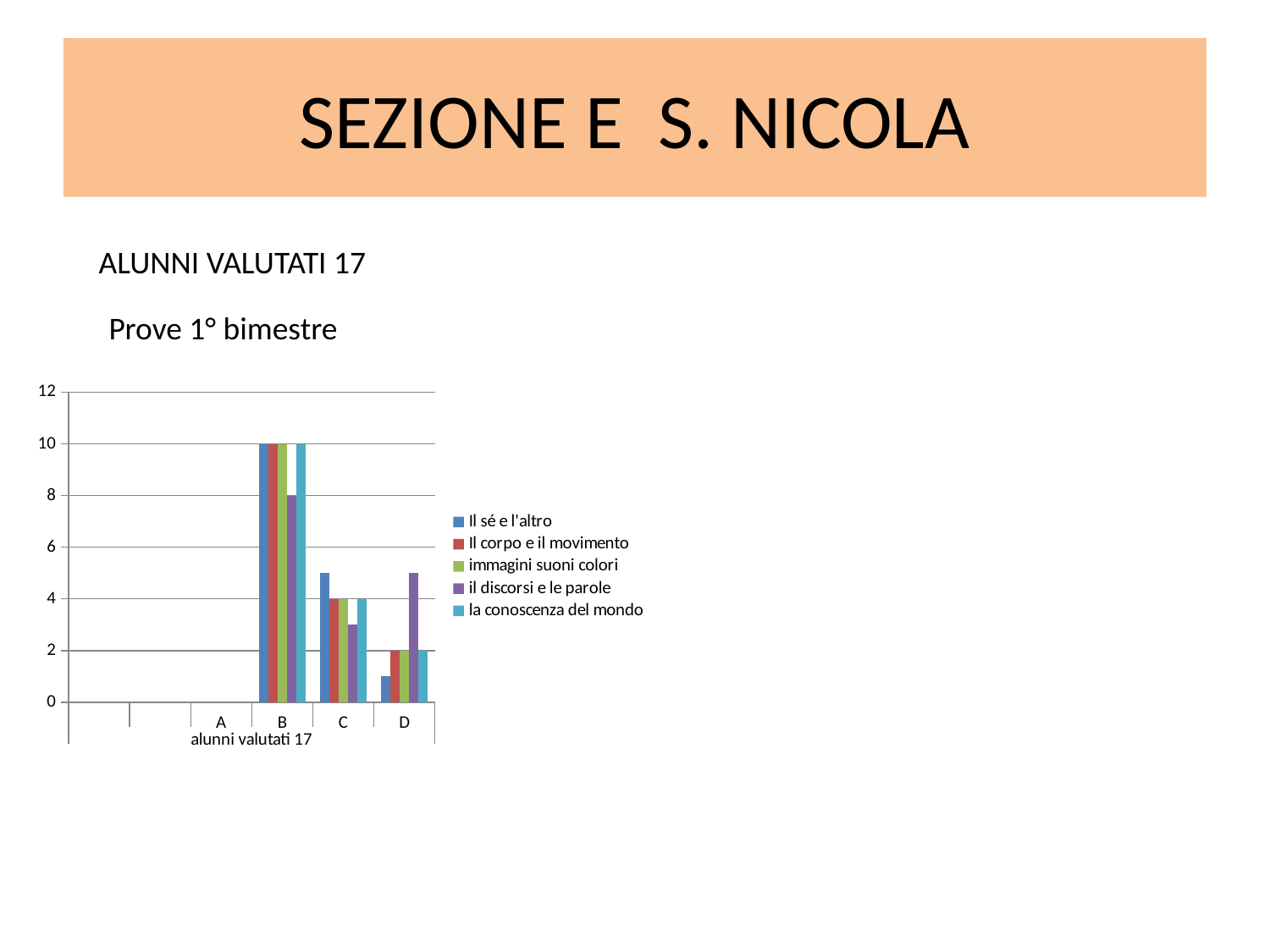
What is the value of 'Il sé e l'altro' for category B? 10 In category D, which series has the larger value: 'il discorsi e le parole' or 'la conoscenza del mondo'? il discorsi e le parole What is the difference between 'Il sé e l'altro' and 'il discorsi e le parole' in category B? 2 What is the value of 'il discorsi e le parole' for category B? 8 What kind of chart is shown on the slide? bar chart Which category has the highest value for 'la conoscenza del mondo'? B What is the value of 'la conoscenza del mondo' for category C? 4 What is the value of 'Il corpo e il movimento' for category D? 2 What is the title shown above the chart? Prove 1° bimestre How many series does the chart legend list? 5 Is the value of 'Il sé e l'altro' for category D greater or less than 2? less Is the value of 'Il sé e l'altro' for category C greater or less than 4? greater